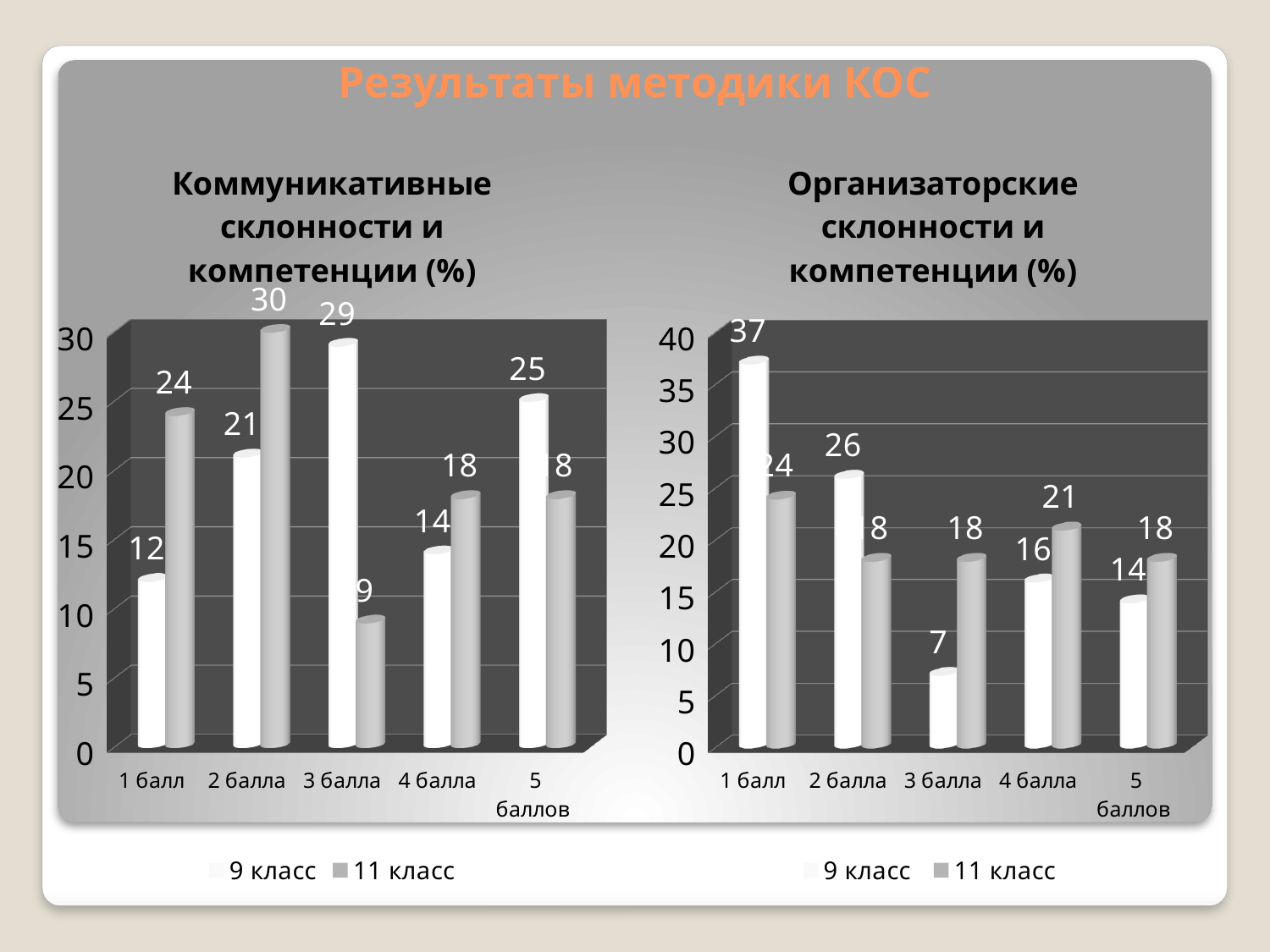
In the chart 'Организаторские склонности и компетенции (%)', which category has the lowest value for 9 класс? 3 балла What type of chart is 'Организаторские склонности и компетенции (%)'? Bar chart In the chart 'Организаторские склонности и компетенции (%)', what is the value for 9 класс at 1 балл? 37 In the chart 'Коммуникативные склонности и компетенции (%)', which is larger at 1 балл: 9 класс or 11 класс? 11 класс In the chart 'Коммуникативные склонности и компетенции (%)', what is the value for 9 класс at 3 балла? 29 How many series does the legend of the chart 'Коммуникативные склонности и компетенции (%)' list? 2 In the chart 'Коммуникативные склонности и компетенции (%)', what is the value for 11 класс at 2 балла? 30 In the chart 'Организаторские склонности и компетенции (%)', what is the difference between 9 класс and 11 класс at 1 балл? 13 In the chart 'Коммуникативные склонности и компетенции (%)', what is the difference between 9 класс and 11 класс at 3 балла? 20 How many categories are shown on the x axis of the chart 'Организаторские склонности и компетенции (%)'? 5 In the chart 'Коммуникативные склонности и компетенции (%)', which category has the highest value for 11 класс? 2 балла In the chart 'Организаторские склонности и компетенции (%)', what is the value for 11 класс at 4 балла? 21